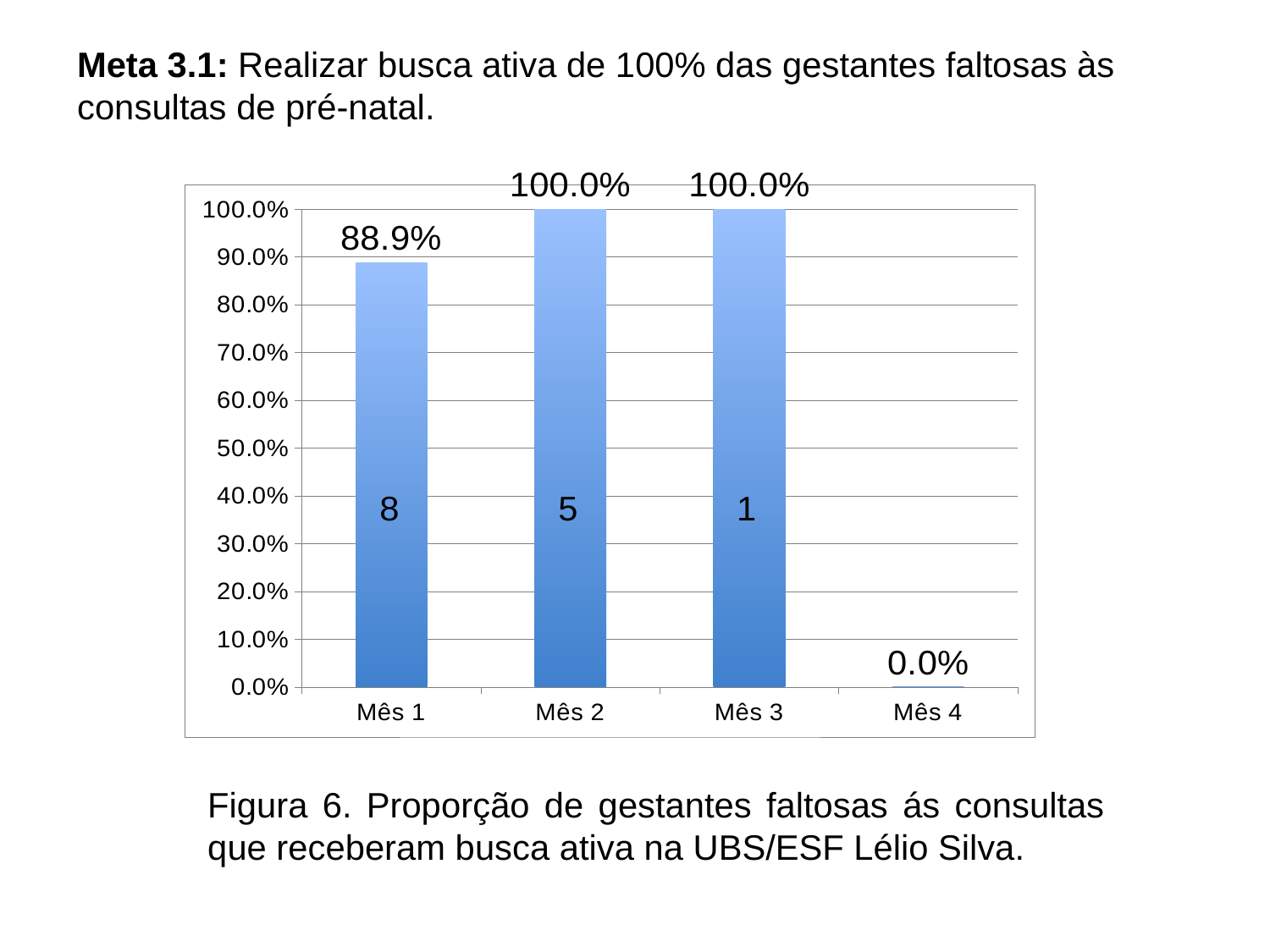
What number is printed inside the bar for Mês 1? 8 What kind of chart is shown on the slide? Bar chart What is the percentage value shown for Mês 4? 0.0% What is the figure number given in the caption below the chart? Figura 6 How many months (categories) are shown on the x axis? 4 Which month has the lowest percentage value? Mês 4 Which is larger, the percentage for Mês 1 or for Mês 3? Mês 3 What number is printed inside the bar for Mês 3? 1 What is the difference in percentage points between Mês 2 and Mês 1? 11.1% Is the value for Mês 1 greater or less than 80.0%? greater What is the percentage value shown for Mês 2? 100.0% What is the percentage value shown for Mês 1? 88.9%